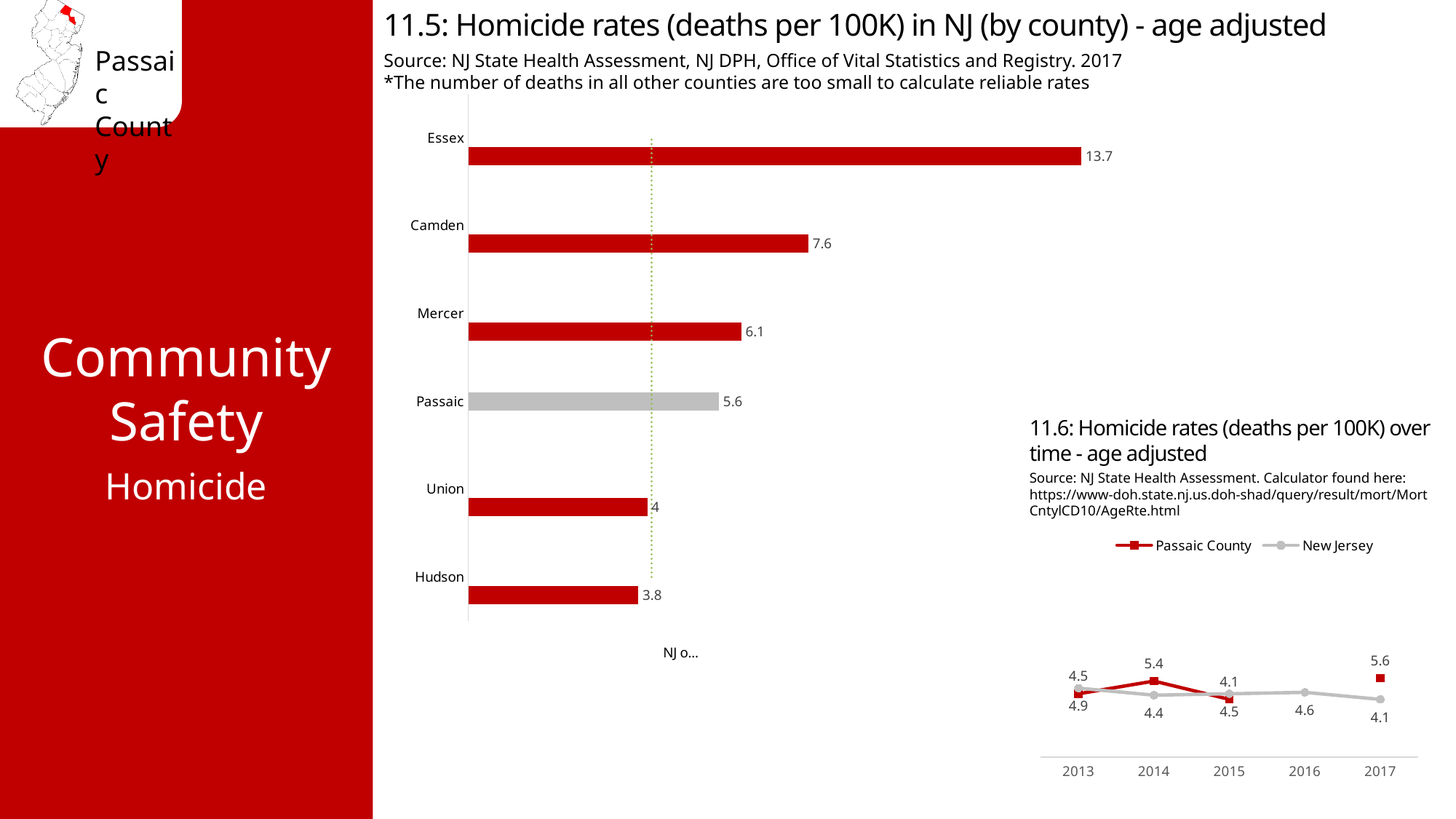
In chart 11.6 (homicide rates over time), what is the difference between the Passaic County and New Jersey rates in 2014? 1 In chart 11.5 (homicide rates by county), which county has the highest homicide rate? Essex In chart 11.5 (homicide rates by county), which county has the lowest homicide rate? Hudson In chart 11.5 (homicide rates by county), what is the homicide rate for Passaic? 5.6 How many series does the legend of chart 11.6 (homicide rates over time) list? 2 In chart 11.6 (homicide rates over time), what was the Passaic County rate in 2017? 5.6 In chart 11.5 (homicide rates by county), how many counties are shown? 6 In chart 11.5 (homicide rates by county), what is the difference between the rates for Camden and Mercer? 1.5 What kind of chart is chart 11.5 (homicide rates by county)? Bar chart In chart 11.6 (homicide rates over time), what was the New Jersey rate in 2016? 4.6 In chart 11.5 (homicide rates by county), which has a higher homicide rate, Union or Hudson? Union In chart 11.5 (homicide rates by county), what is the homicide rate for Essex? 13.7